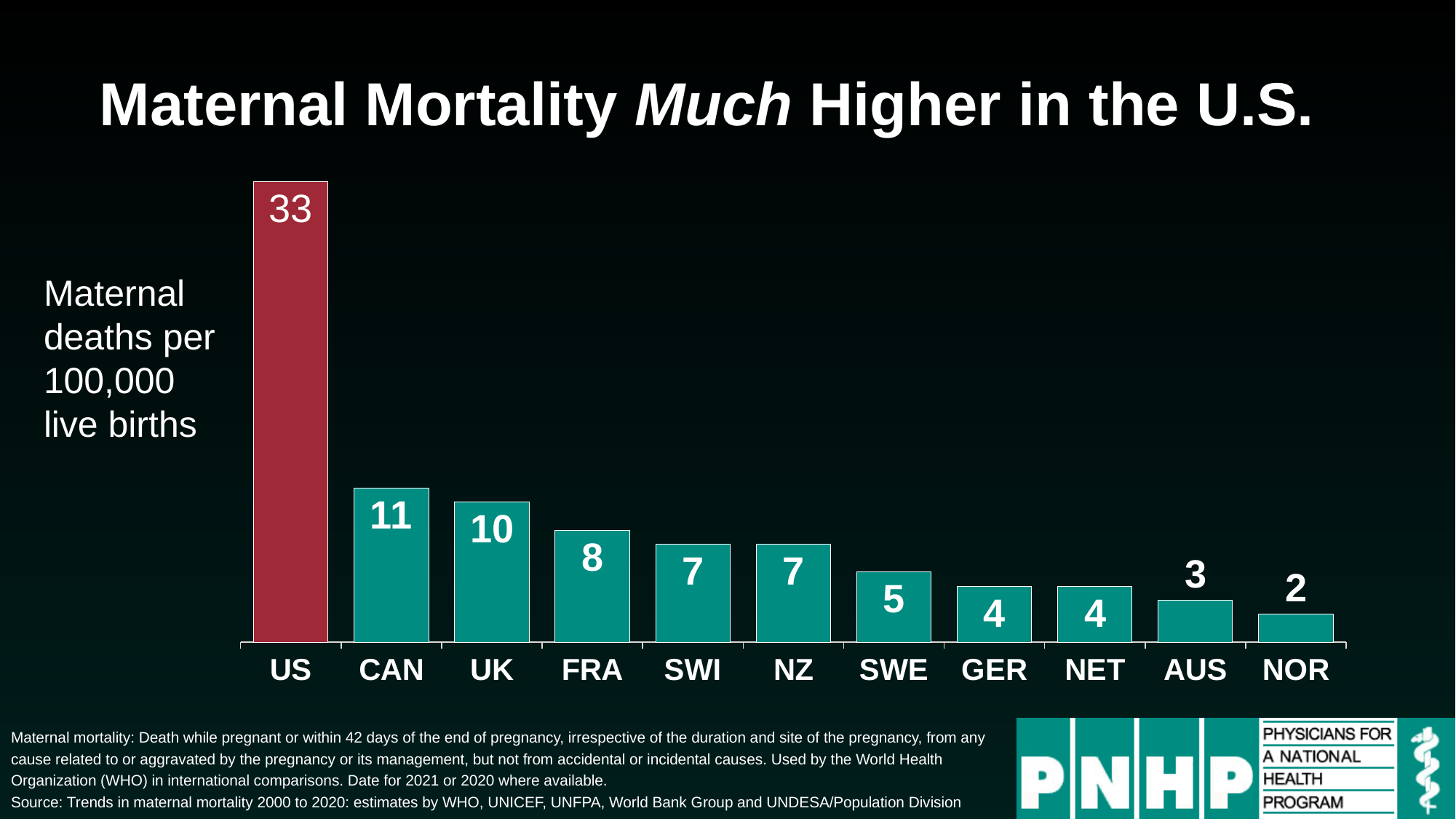
Which bar is coloured differently from the others? US Which country has the lowest maternal mortality on the chart? NOR Do the values generally rise or fall from left to right along the x axis? Fall What is the value shown for CAN? 11 What is the maternal mortality value for the US? 33 What is the difference between the US value and the CAN value? 22 Which country has the highest maternal mortality on the chart? US What is the difference between the UK value and the NOR value? 8 What is the value shown for SWE? 5 How many countries are shown on the chart? 11 What kind of chart is shown on the slide? Bar chart Which has a higher value, FRA or GER? FRA